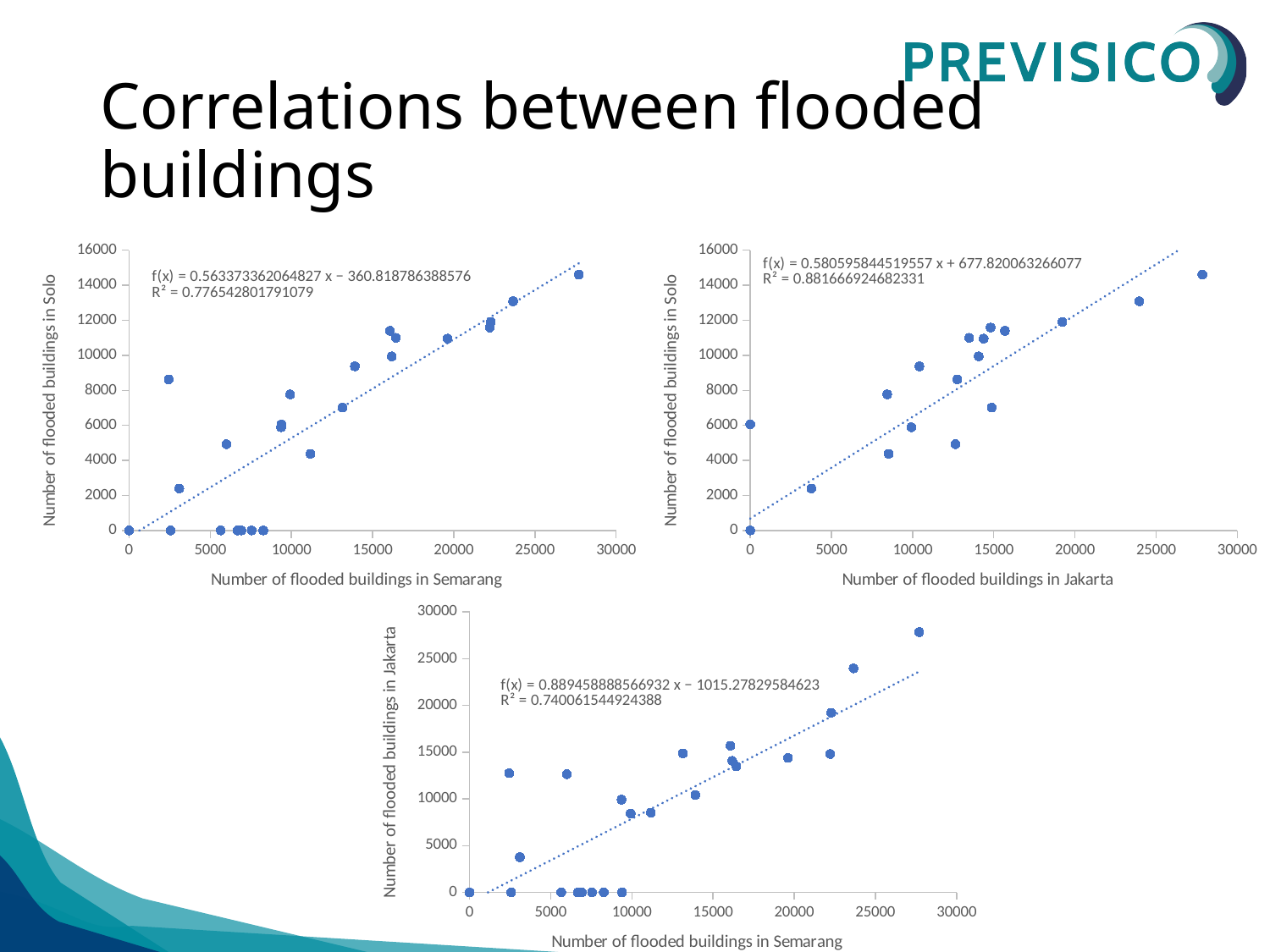
What kind of chart is the top-left chart (Solo vs Semarang)? scatter chart What is the y-axis label of the bottom chart? Number of flooded buildings in Jakarta In the top-left chart, do the number of flooded buildings in Solo generally rise or fall as the number of flooded buildings in Semarang increases? rise In the top-left chart, is the y value of the rightmost point greater or less than 12000? greater In the top-right chart, do the number of flooded buildings in Solo generally rise or fall as the number of flooded buildings in Jakarta increases? rise In the bottom chart, do the number of flooded buildings in Jakarta generally rise or fall as the number of flooded buildings in Semarang increases? rise In the top-right chart, is the y value of the rightmost point greater or less than 12000? greater In the bottom chart, is the y value of the highest point greater or less than 25000? greater What R² value is printed on the top-left chart? 0.776542801791079 How many charts are shown on the slide? 3